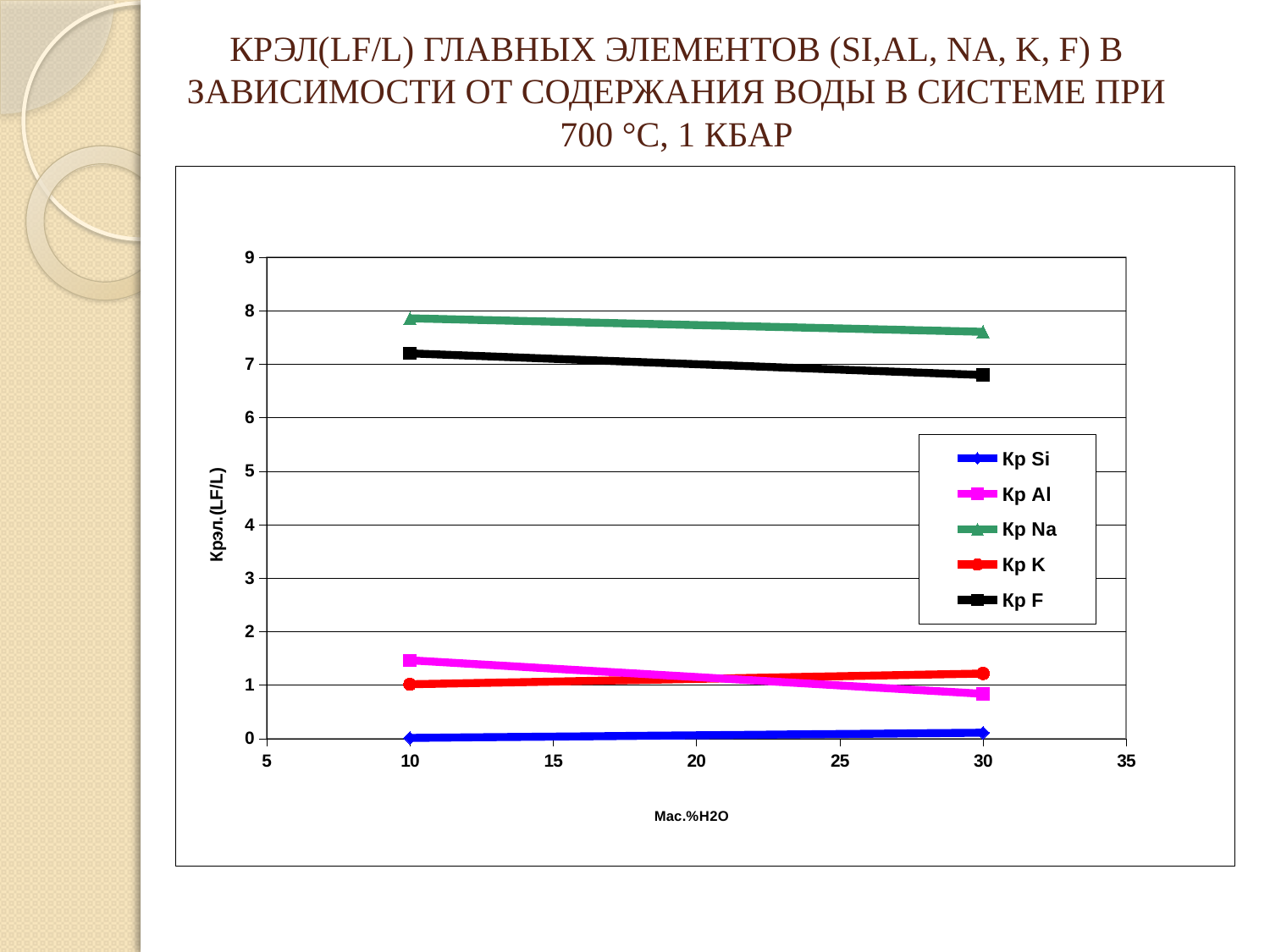
Does the Kp Al series rise or fall from 10 to 30 Мас.%H2O? fall At 10 Мас.%H2O, which is larger: Kp Na or Kp F? Kp Na Which series has the lowest value at 10 Мас.%H2O? Kp Si How many data points does the Kp Na series have? 2 Is the value for Kp Na at 10 Мас.%H2O greater or less than 7? greater Which series has the highest value at 30 Мас.%H2O? Kp Na What kind of chart is shown on the slide? line chart How many series does the legend list? 5 Is the value for Kp F at 30 Мас.%H2O greater or less than 7? less Is the value for Kp Al at 10 Мас.%H2O greater or less than 1? greater What is the label of the x axis? Мас.%H2O Does the Kp K series rise or fall from 10 to 30 Мас.%H2O? rise